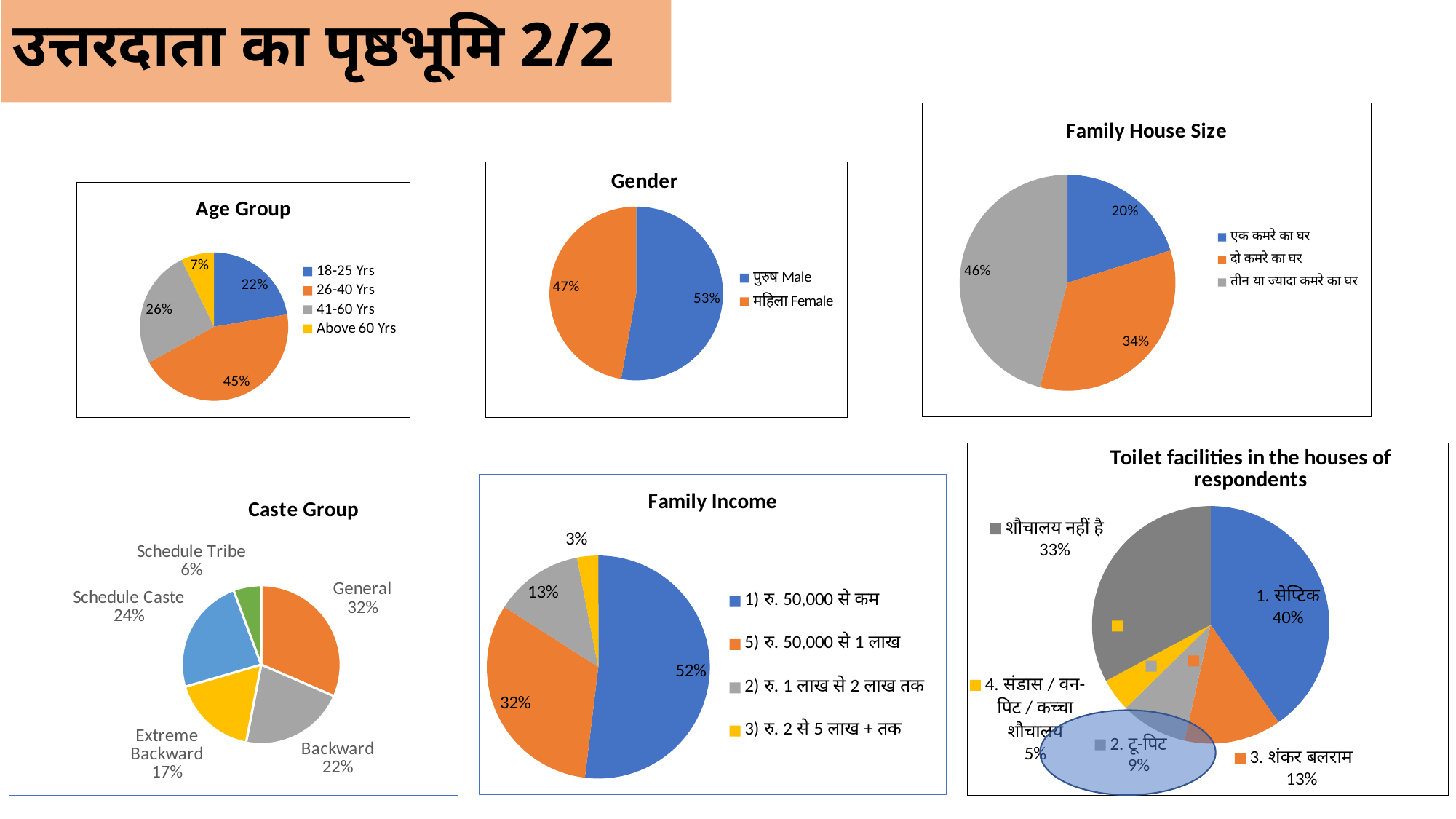
In the Family Income chart, which is larger: the share for रु. 1 लाख से 2 लाख तक or the share for रु. 2 से 5 लाख + तक? रु. 1 लाख से 2 लाख तक In the Family Income chart, what share of respondents have income of रु. 50,000 से कम? 52% In the Family House Size chart, what share of respondents live in a house with three or more rooms (तीन या ज्यादा कमरे का घर)? 46% In the Age Group chart, which age group has the smallest share? Above 60 Yrs In the Caste Group chart, which caste group has the largest share? General In the Gender chart, what is the difference between the Male and Female shares? 6% In the Age Group chart, what share of respondents are in the 26-40 Yrs group? 45% In the Gender chart, what percentage of respondents are Male? 53% What type of chart is used for the Age Group data? Pie chart In the Caste Group chart, what is the share for Schedule Caste? 24% In the Toilet facilities chart, what share of respondents have no toilet (शौचालय नहीं है)? 33% How many categories does the Family House Size chart show? 3